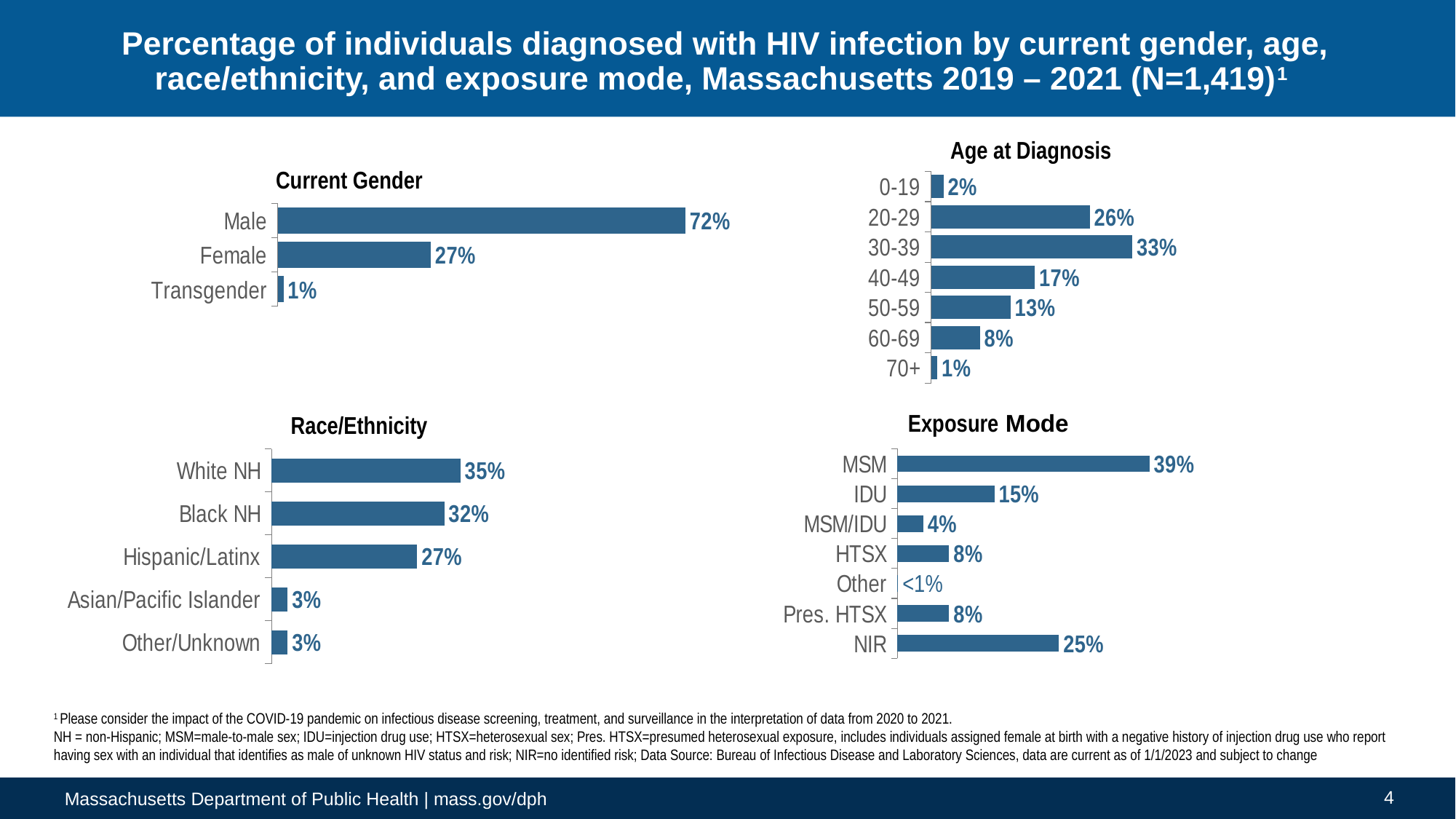
In the Race/Ethnicity chart, which is larger, Black NH or Hispanic/Latinx? Black NH In the Race/Ethnicity chart, what is the difference between White NH and Hispanic/Latinx? 8% What type of chart is the Current Gender chart? Bar chart In the Age at Diagnosis chart, what is the value for 50-59? 13% In the Age at Diagnosis chart, which age group has the highest percentage? 30-39 In the Current Gender chart, what is the difference between Male and Female? 45% How many categories are shown in the Age at Diagnosis chart? 7 In the Exposure Mode chart, what is the value for NIR? 25% In the Exposure Mode chart, what is the value shown for Other? <1% In the Exposure Mode chart, which category has the highest percentage? MSM How many categories are shown in the Race/Ethnicity chart? 5 In the Current Gender chart, what percentage is shown for Male? 72%